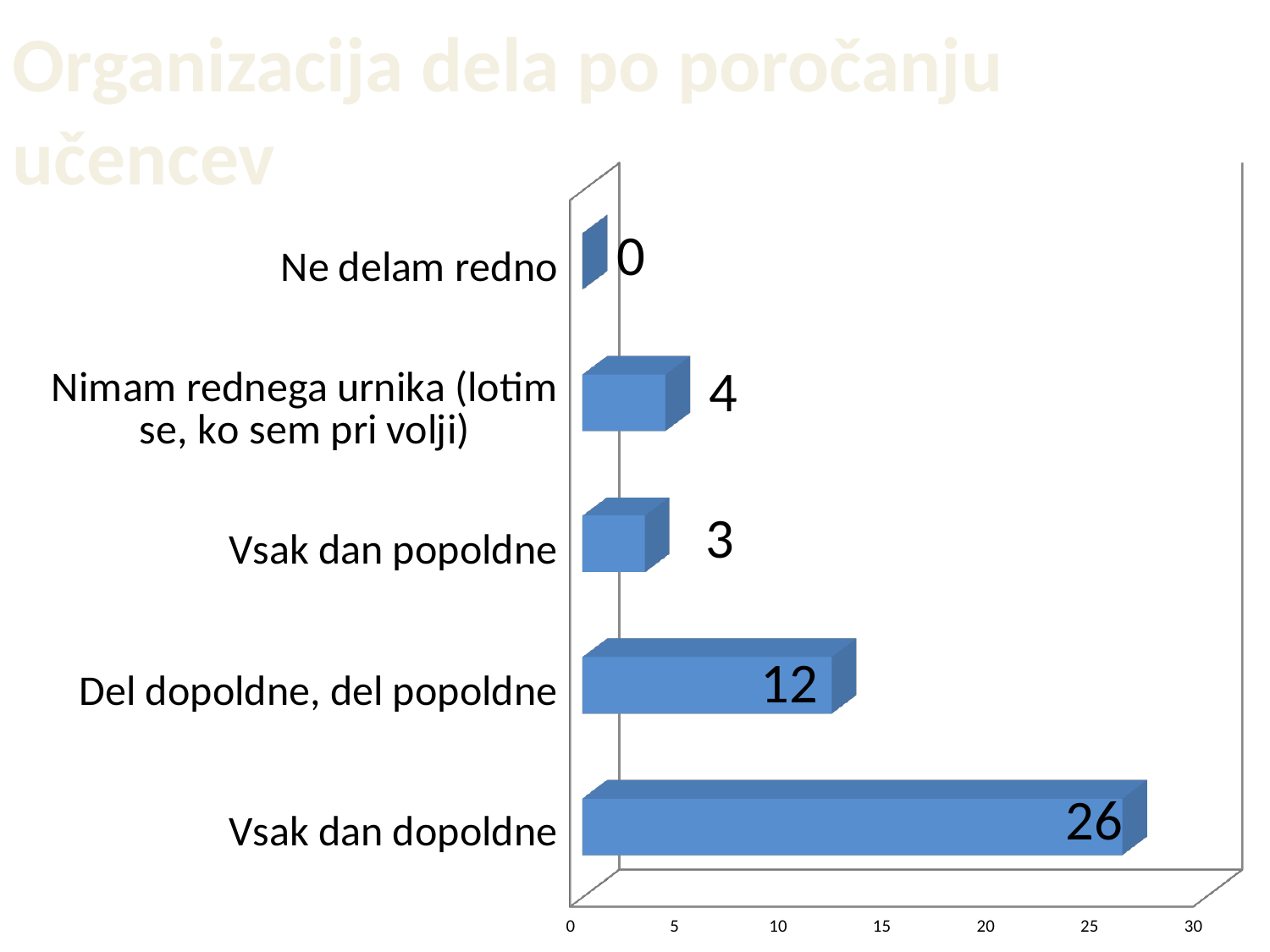
What is the value for Nimam rednega urnika (lotim se, ko sem pri volji)? 4 What is the value for Ne delam redno? 0 Which category has the highest value? Vsak dan dopoldne What is the value for Vsak dan dopoldne? 26 What is the value for Vsak dan popoldne? 3 What kind of chart is shown on the slide? Bar chart How many categories are shown in the chart? 5 What is the difference between the values for Vsak dan dopoldne and Del dopoldne, del popoldne? 14 What is the title of the slide? Organizacija dela po poročanju učencev Which is larger, the value for Nimam rednega urnika (lotim se, ko sem pri volji) or the value for Vsak dan popoldne? Nimam rednega urnika (lotim se, ko sem pri volji) Which category has the lowest value? Ne delam redno What is the value for Del dopoldne, del popoldne? 12